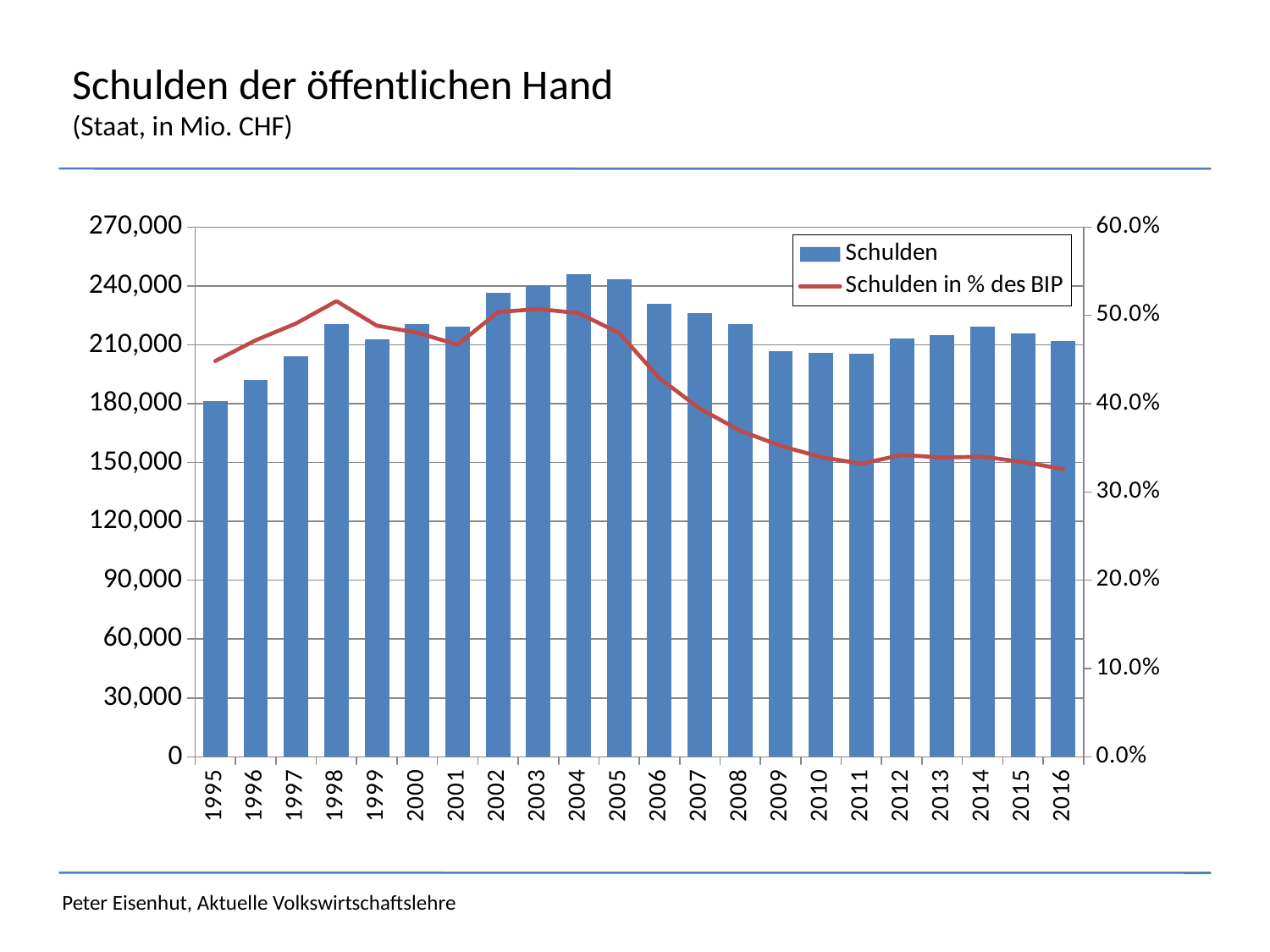
Is the Schulden value for 1995 greater or less than 210,000? less Is the Schulden value for 2004 greater or less than 240,000? greater Which is larger, the Schulden value for 2003 or for 2010? 2003 What kind of chart is shown on the slide? A combined bar and line chart Is the Schulden in % des BIP value for 2016 greater or less than 40.0%? less How many series does the legend list? 2 What colour are the Schulden bars? Blue Does the Schulden in % des BIP line rise or fall from 2005 to 2011? fall How many years are shown on the x axis? 22 Which year has the lowest Schulden bar? 1995 Which year has the highest Schulden bar? 2004